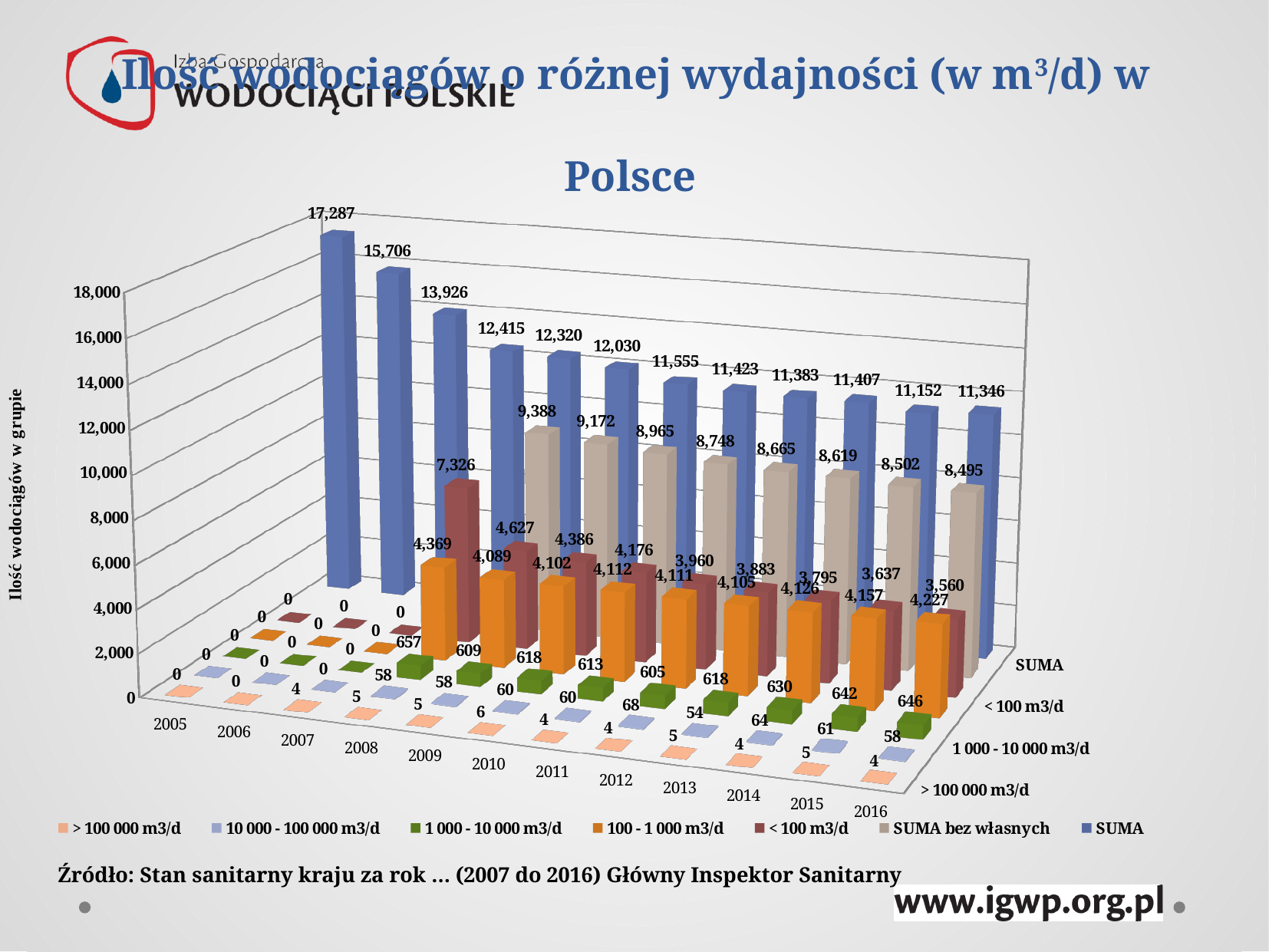
Does the SUMA series generally rise or fall from 2005 to 2016? fall What is the value of the 100 - 1 000 m3/d series for 2016? 4,227 What is the value of the < 100 m3/d series for 2008? 7,326 What kind of chart is shown on the slide? bar chart Which is larger, the SUMA value for 2013 or for 2014? 2014 Which year has the lowest SUMA value? 2015 How many years are shown on the x axis? 12 What is the value of the SUMA series for 2005? 17,287 What is the difference between the SUMA values for 2005 and 2006? 1,581 What is the value of the SUMA series for 2016? 11,346 How many series does the legend list? 7 Which year has the highest SUMA value? 2005